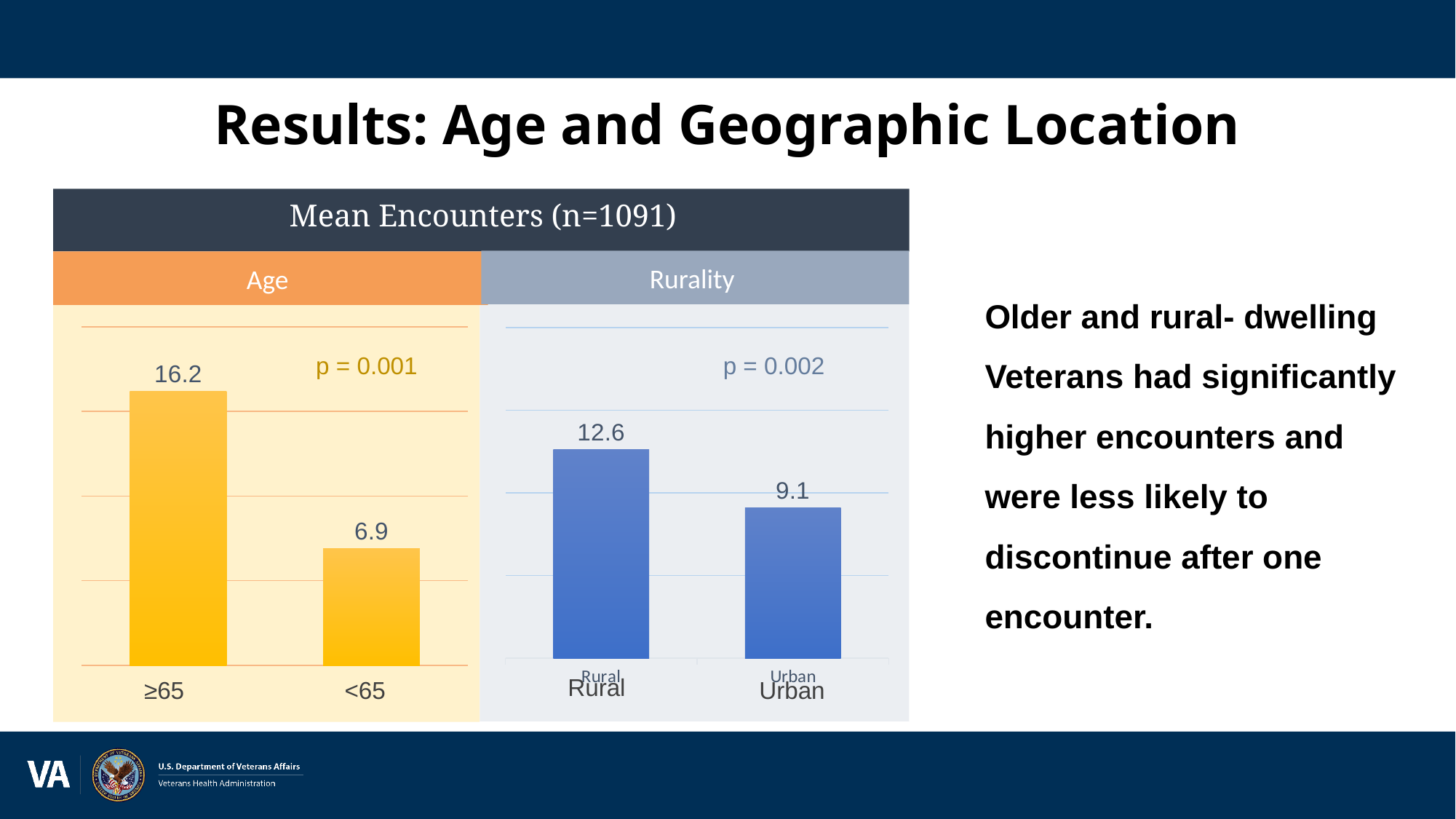
In the Age chart, which group has the higher mean encounters? ≥65 In the Rurality chart, what is the mean encounters value for Urban? 9.1 What type of chart is used to show mean encounters by Rurality? bar chart In the Age chart, what is the difference in mean encounters between the ≥65 and <65 groups? 9.3 In the Age chart, what is the mean encounters value for the <65 group? 6.9 Is the mean encounters value for Rural larger or smaller than the value for ≥65? smaller In the Age chart, what is the mean encounters value for the ≥65 group? 16.2 In the Rurality chart, what is the mean encounters value for Rural? 12.6 What p-value is shown on the Age chart? p = 0.001 How many bars are shown in the Age chart? 2 In the Rurality chart, which group has the lower mean encounters? Urban In the Rurality chart, what is the difference in mean encounters between Rural and Urban? 3.5